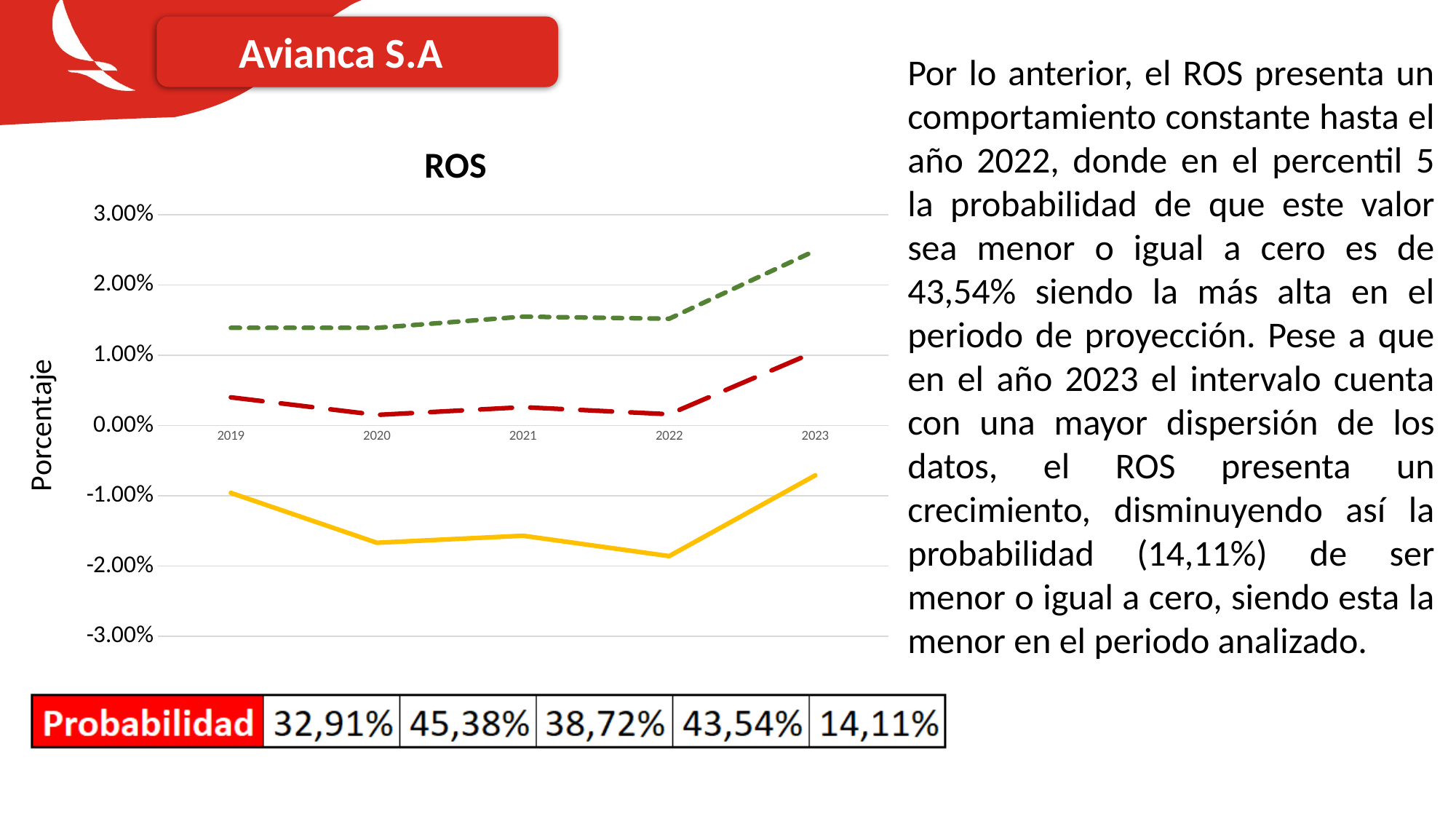
In which year does the yellow solid line reach its lowest value? 2022 Is the value of the green dotted line in 2019 greater or less than 1.00%? greater Is the value of the red dashed line in 2019 greater or less than 0.00%? greater How many years are shown along the x axis of the chart? 5 What is the label on the vertical axis of the chart? Porcentaje Does the yellow solid line rise or fall from 2022 to 2023? rise What is the title of the chart? ROS In which year does the green dotted line reach its highest value? 2023 What kind of chart is shown on the slide? line chart Is the value of the green dotted line in 2023 greater or less than 2.00%? greater How many lines are plotted on the chart? 3